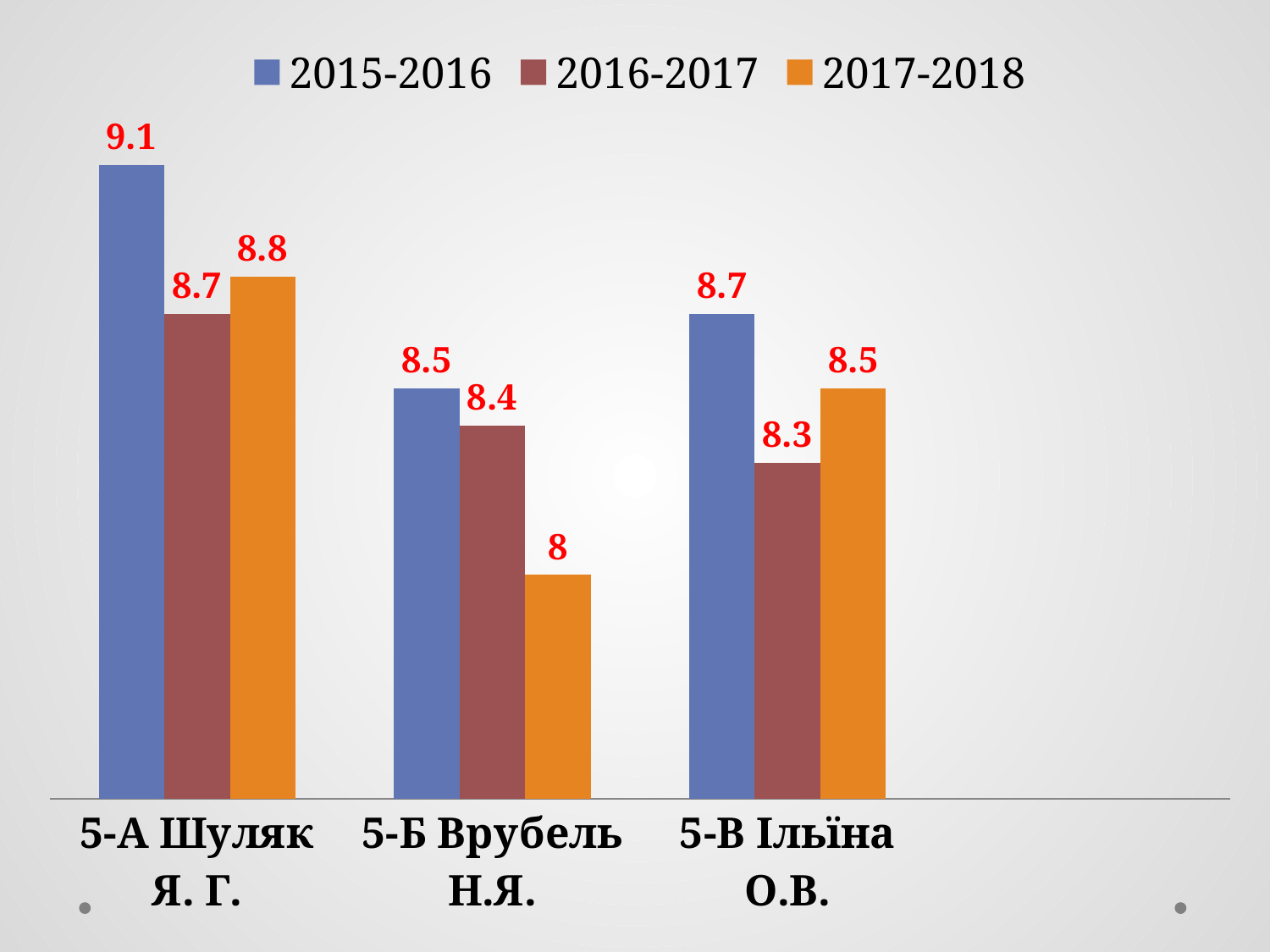
Which category has the highest value in the 2015-2016 series? 5-А Шуляк Я. Г. Which is larger for 5-В Ільїна О.В.: the 2015-2016 value or the 2017-2018 value? 2015-2016 What is the value for 5-В Ільїна О.В. in 2016-2017? 8.3 Which category has the lowest value in the 2017-2018 series? 5-Б Врубель Н.Я. How many categories are shown on the x axis? 3 What kind of chart is shown on the slide? Bar chart Which series is shown in orange in the legend? 2017-2018 What is the difference between the 2016-2017 values for 5-А Шуляк Я. Г. and 5-В Ільїна О.В.? 0.4 What is the difference between the 2015-2016 and 2017-2018 values for 5-Б Врубель Н.Я.? 0.5 What is the value for 5-А Шуляк Я. Г. in 2015-2016? 9.1 What is the value for 5-Б Врубель Н.Я. in 2017-2018? 8 How many series does the legend list? 3